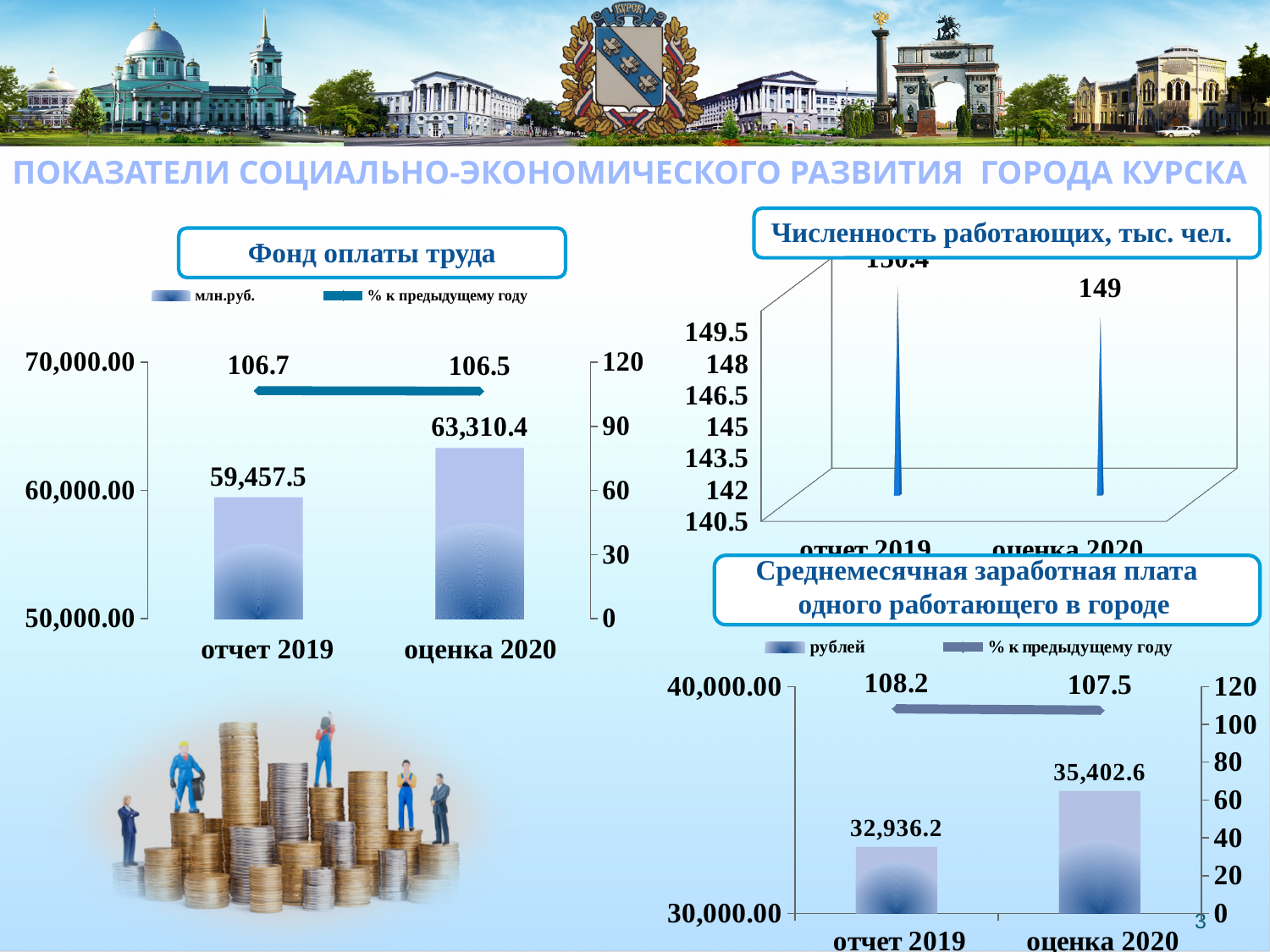
In the 'Среднемесячная заработная плата одного работающего в городе' chart, what is the value of the bar for отчет 2019? 32,936.2 In the 'Фонд оплаты труда' chart, what is the difference between the bar values for оценка 2020 and отчет 2019? 3,852.9 In the 'Среднемесячная заработная плата одного работающего в городе' chart, what is the value of the bar for оценка 2020? 35,402.6 In the 'Среднемесячная заработная плата одного работающего в городе' chart, what is the '% к предыдущему году' value for отчет 2019? 108.2 In the 'Среднемесячная заработная плата одного работающего в городе' chart, do the bar values rise or fall from отчет 2019 to оценка 2020? rise In the 'Фонд оплаты труда' chart, what is the '% к предыдущему году' value for оценка 2020? 106.5 In the 'Фонд оплаты труда' chart, what is the value of the bar for оценка 2020? 63,310.4 In the 'Фонд оплаты труда' chart, what is the value of the bar for отчет 2019? 59,457.5 In the 'Численность работающих, тыс. чел.' chart, which category has the higher value, отчет 2019 or оценка 2020? отчет 2019 In the 'Численность работающих, тыс. чел.' chart, what is the value for оценка 2020? 149 How many series does the legend of the 'Фонд оплаты труда' chart list? 2 In the 'Среднемесячная заработная плата одного работающего в городе' chart, what is the difference between the bar values for оценка 2020 and отчет 2019? 2,466.4